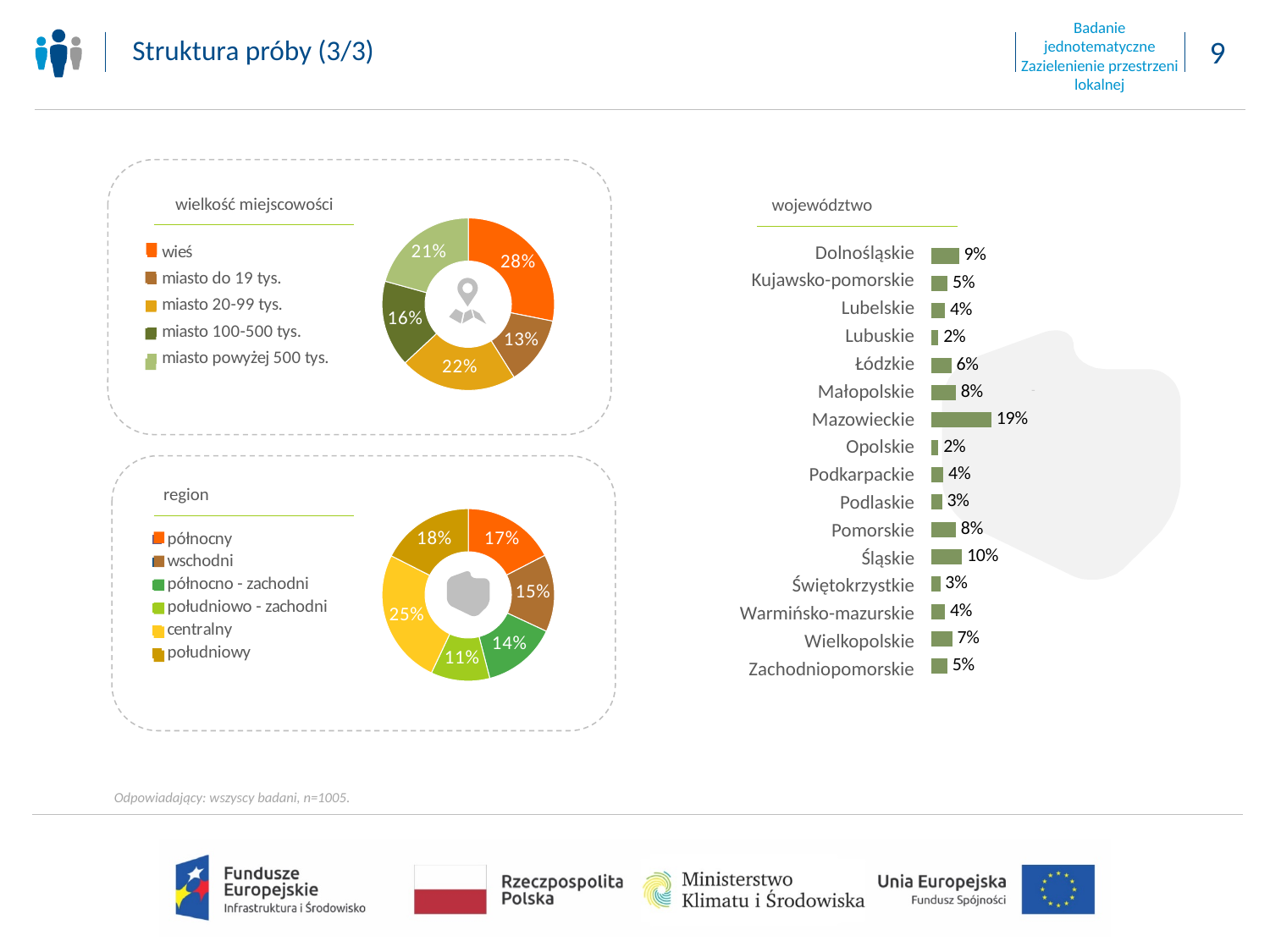
In the 'wielkość miejscowości' chart, what is the difference between the shares for 'miasto 20-99 tys.' and 'miasto 100-500 tys.'? 6 percentage points In the 'wielkość miejscowości' chart, what share is shown for 'wieś'? 28% In the 'województwo' chart, what is the difference between the values for Mazowieckie and Dolnośląskie? 10 percentage points In the 'region' chart, what share is shown for 'południowo - zachodni'? 11% In the 'region' chart, how many regions are listed in the legend? 6 In the 'województwo' chart, how many voivodeships are shown? 16 What type of chart is the 'województwo' chart? Bar chart In the 'wielkość miejscowości' chart, which category has the smallest share? miasto do 19 tys. In the 'region' chart, which region has the largest share? centralny In the 'województwo' chart, which voivodeship has the highest value? Mazowieckie In the 'województwo' chart, what is the value for Śląskie? 10% In the 'region' chart, which is larger: 'północny' or 'wschodni'? północny